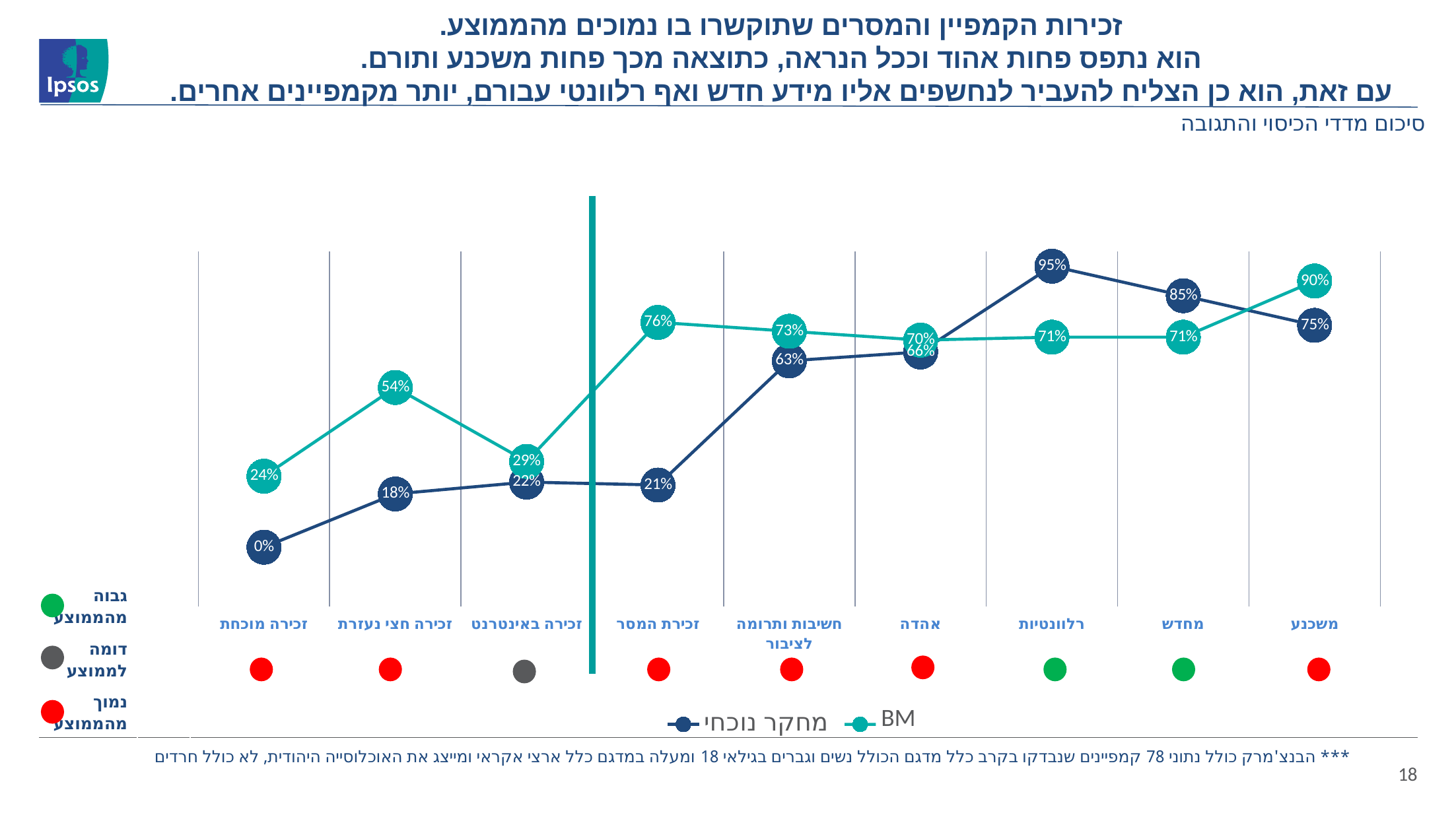
What is the difference between the BM value and the מחקר נוכחי value for זכירת המסר? 55% What value does the BM series show for זכירת המסר? 76% What value does the מחקר נוכחי series show for זכירה מוכחת? 0% Which category has the highest value in the מחקר נוכחי series? רלוונטיות What value does the מחקר נוכחי series show for רלוונטיות? 95% What is the difference between the מחקר נוכחי values for רלוונטיות and משכנע? 20% Which category has the lowest value in the BM series? זכירה מוכחת What kind of chart is shown on the slide? Line chart What value does the BM series show for משכנע? 90% For מחדש, which series has the larger value, מחקר נוכחי or BM? מחקר נוכחי How many series does the legend list? 2 How many categories are plotted along the x axis? 9